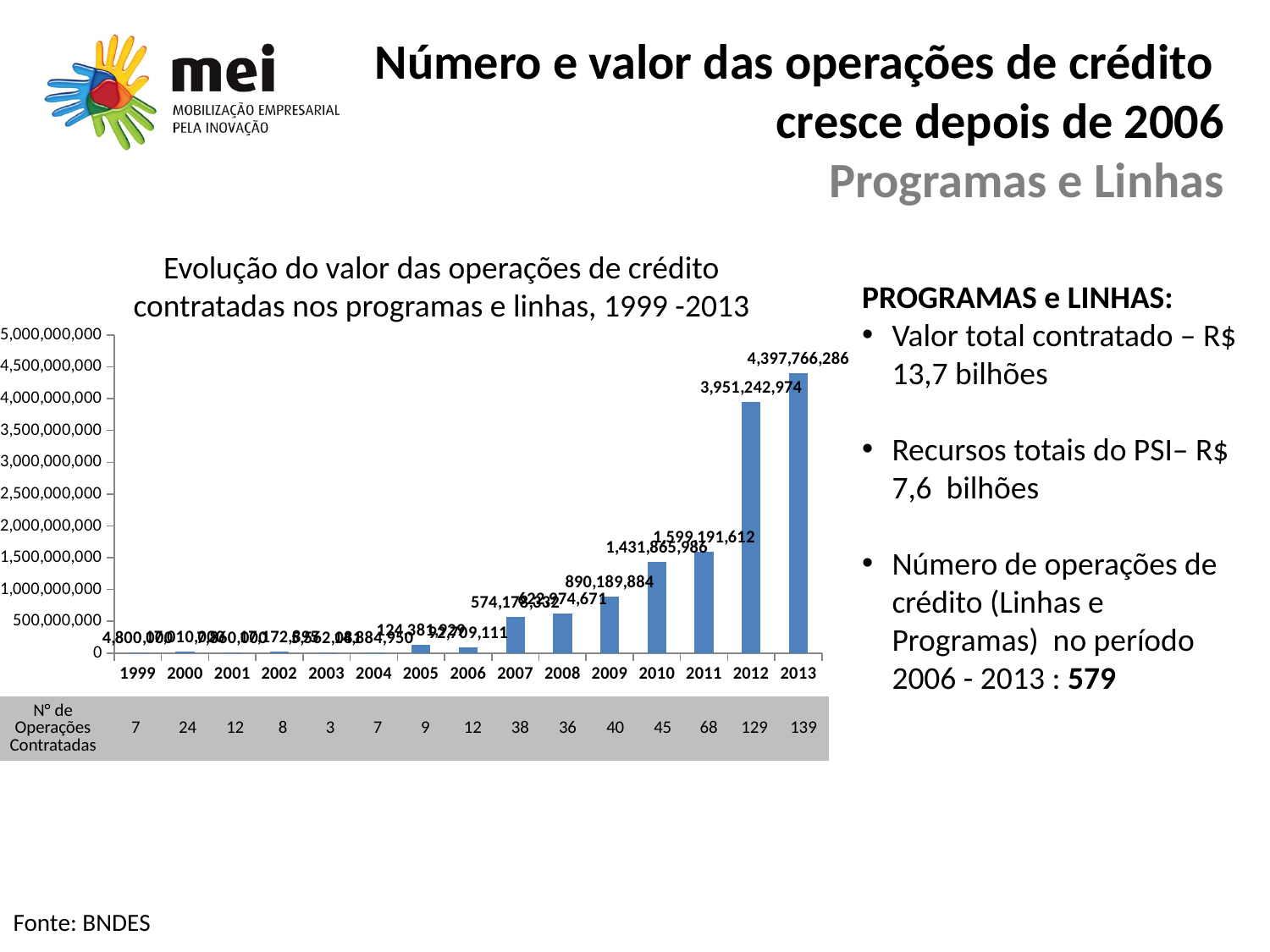
Do the values of credit operations generally rise or fall from 2006 to 2013? Rise According to the table below the chart, how many credit operations were contracted in 2013? 139 What is the value of credit operations contracted in 2009? 890,189,884 Which year has the highest value of credit operations contracted? 2013 What is the value of credit operations contracted in 2012? 3,951,242,974 Is the value for 2005 greater or less than 500,000,000? less How many years are shown on the x axis of the chart? 15 Which year has the larger value of credit operations, 2010 or 2009? 2010 What is the difference between the values for 2013 and 2012? 446,523,312 What kind of chart is used to show the evolution of credit operations? Bar chart Is the value for 2008 greater or less than 500,000,000? greater What is the value of credit operations contracted in 2013? 4,397,766,286